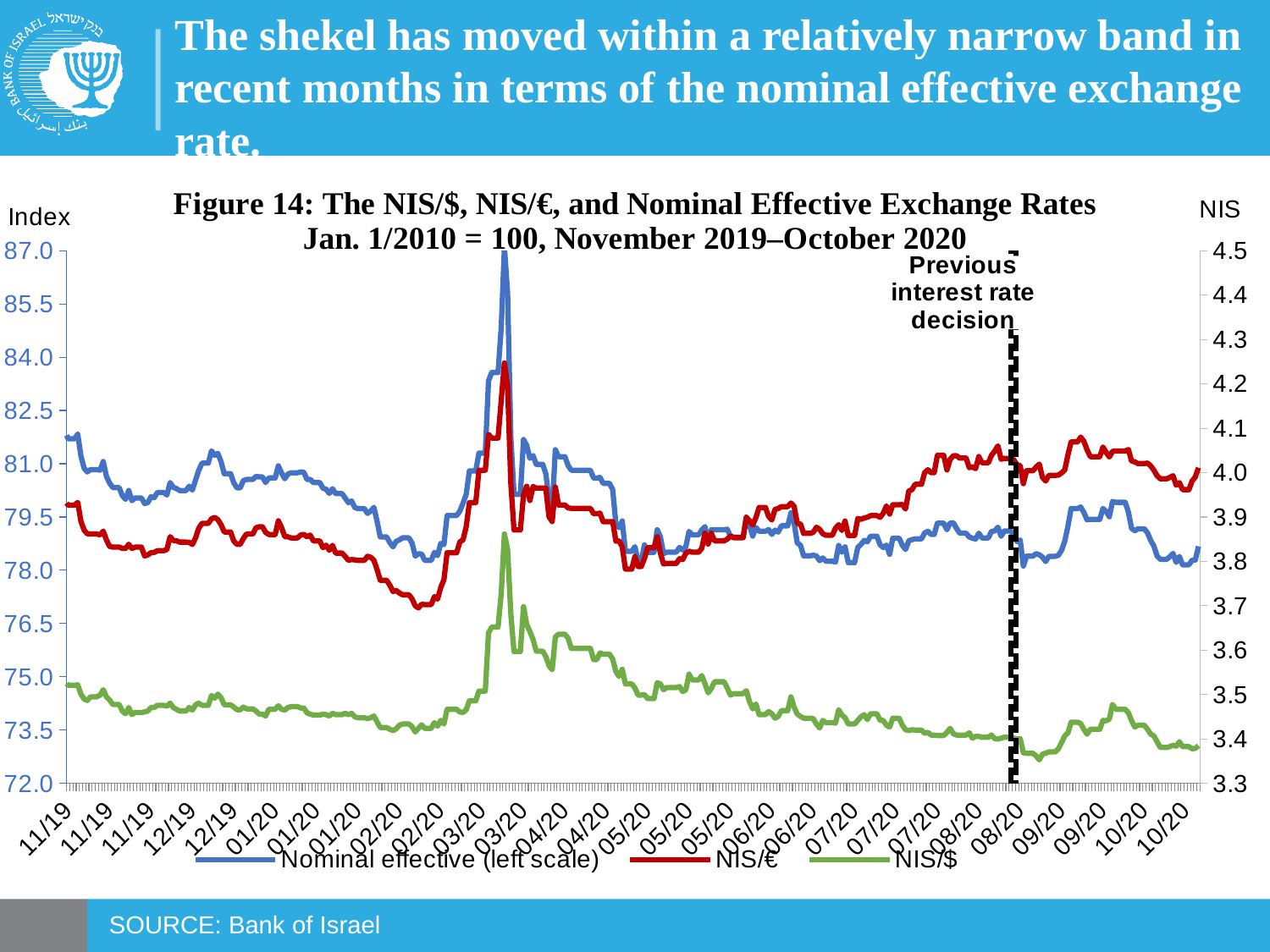
What does the dashed vertical line in the chart mark? Previous interest rate decision From its March 2020 peak to October 2020, does the NIS/$ line rise or fall overall? fall Is the value of the Nominal effective line at the start of the period (11/19) greater or less than 79.5? greater Is the value of the NIS/$ line at its March 2020 peak greater or less than 3.7? greater How many series does the legend list? 3 What kind of chart is shown on the slide? line chart Is the value of the NIS/€ line at the end of the period (10/20) greater or less than 3.9? greater Which series is plotted against the left scale? Nominal effective What is the title of the figure? Figure 14: The NIS/$, NIS/€, and Nominal Effective Exchange Rates In 10/20, which line is higher on the right scale, NIS/€ or NIS/$? NIS/€